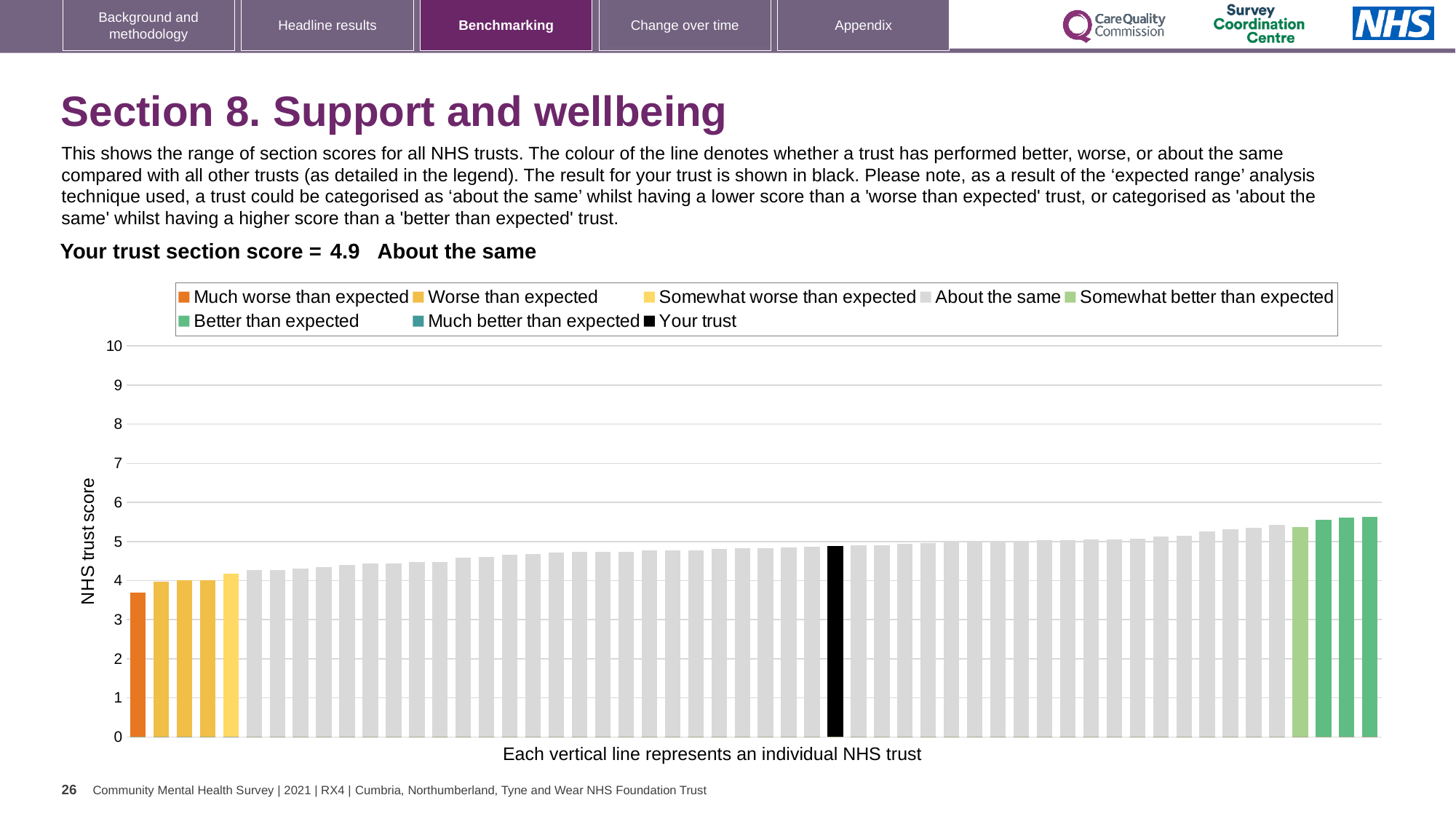
Do the bar values rise or fall from left to right along the x axis? Rise What kind of chart is shown on the slide? Bar chart What is the label on the vertical axis of the chart? NHS trust score Is the value of the leftmost (orange) bar greater or less than 4? less How many bars are coloured as 'Much worse than expected'? 1 Is the value of the black bar for your trust greater or less than 5? less What colour is the bar representing your trust? Black What is the section score for your trust shown on the slide? 4.9 How many bars are coloured as 'Better than expected' (dark green)? 3 Which performance category is your trust placed in for Section 8? About the same Is the value of the rightmost bar greater or less than 5? greater How many entries does the chart legend list? 8